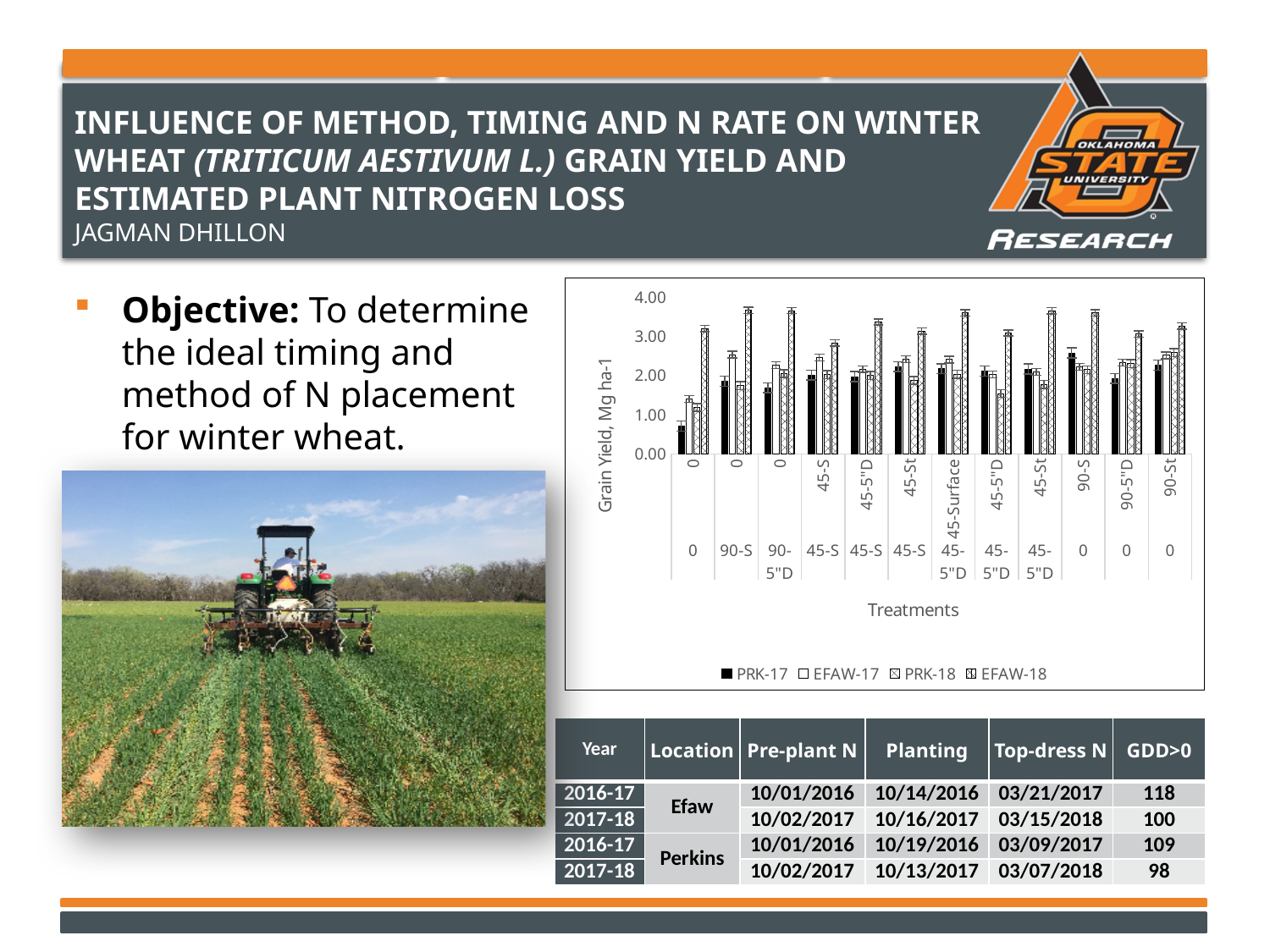
How many series does the chart's legend list? 4 What kind of chart is shown on the slide? bar chart Is the PRK-18 value for the 45-5"D / 45-5"D treatment group greater or less than 2.00? less Is the PRK-17 value for the first treatment group (0 / 0) greater or less than 1.00? less For the PRK-17 series, which treatment group has the lowest grain yield? 0 / 0 (the first group) Is the EFAW-18 value for the 45-S / 45-S treatment group greater or less than 3.00? less What is the label of the chart's y axis? Grain Yield, Mg ha-1 How many treatment groups are plotted along the x axis of the chart? 12 In the first treatment group (0 / 0), which series has the larger value, PRK-17 or EFAW-18? EFAW-18 What are the four series named in the chart's legend? PRK-17, EFAW-17, PRK-18, EFAW-18